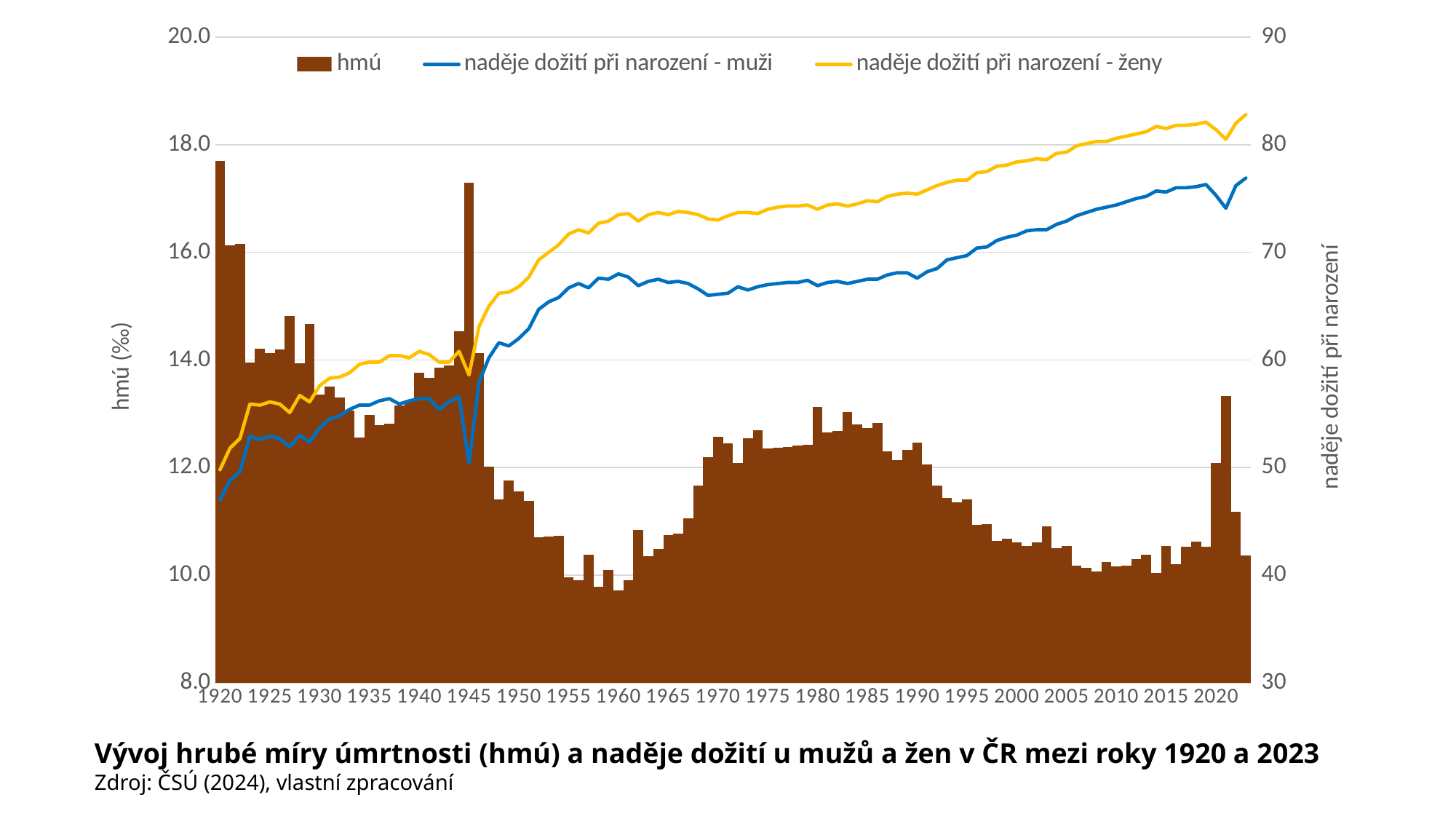
Is the hmú value for 1960 greater or less than 10.0? less Is the value of naděje dožití při narození - muži in 1920 greater or less than 50? less Is the value of naděje dožití při narození - muži in 1945 greater or less than 60? less Does the naděje dožití při narození - muži line generally rise or fall from 1920 to 2023? rise What is the source cited below the chart? ČSÚ (2024), vlastní zpracování How many series does the legend list? 3 In 2000, which is higher: naděje dožití při narození - muži or naděje dožití při narození - ženy? naděje dožití při narození - ženy What kind of chart is this? Combined bar and line chart Do the hmú bars generally rise or fall from 1920 to 1960? fall